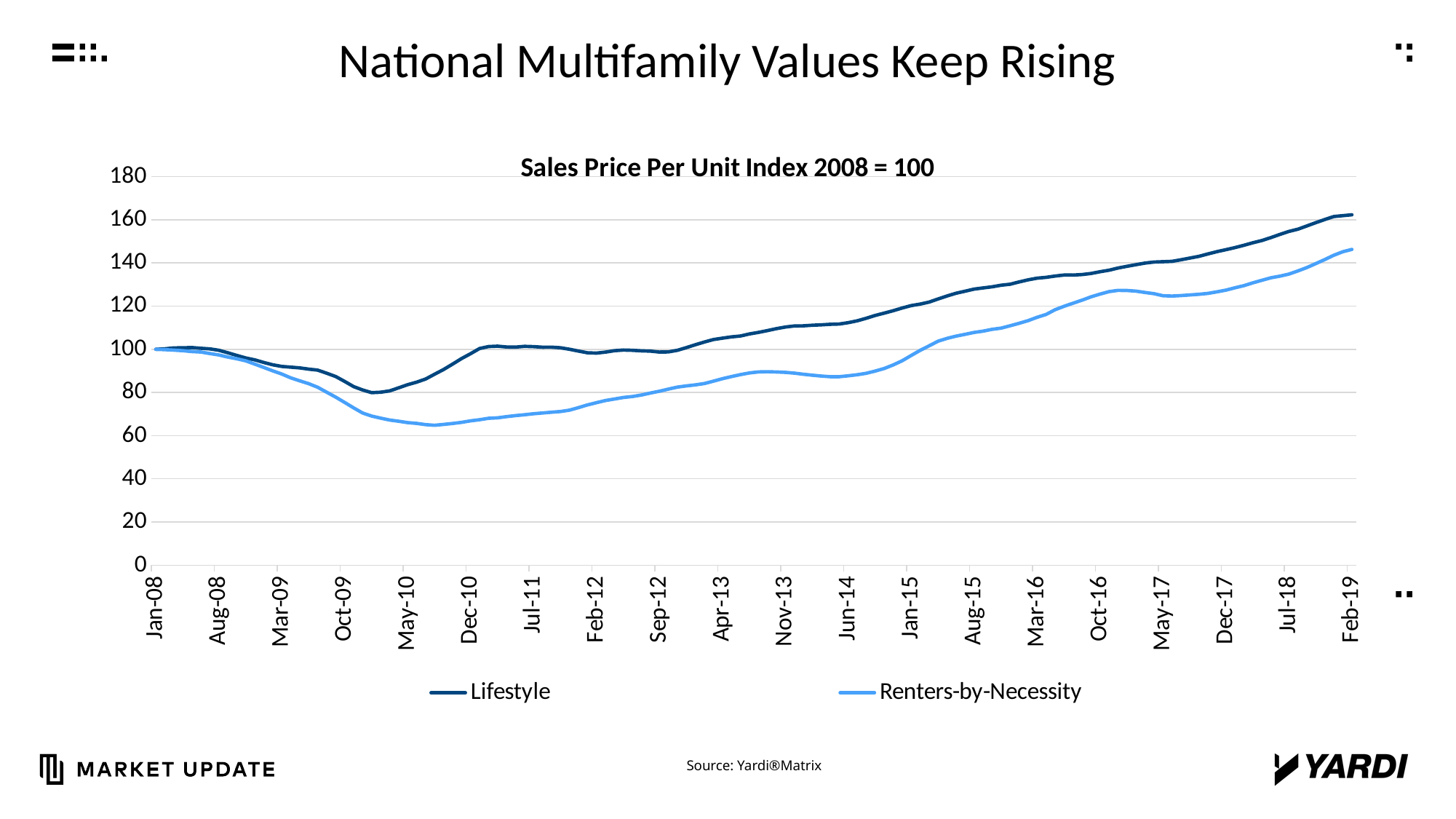
Is the value of the Lifestyle series at Feb-19 greater or less than 140? greater Does the Renters-by-Necessity series rise or fall between Jun-14 and Oct-16? rise What is the value of the Lifestyle series at Jan-08? 100 What is the chart's title? Sales Price Per Unit Index 2008 = 100 How many series does the legend list? 2 At Feb-19, which series has the higher value, Lifestyle or Renters-by-Necessity? Lifestyle Is the value of the Renters-by-Necessity series at May-10 greater or less than 80? less Which two series are shown in the legend? Lifestyle and Renters-by-Necessity Which series falls to the lower minimum value over the period shown? Renters-by-Necessity What kind of chart is shown on the slide? line chart Does the Lifestyle series rise or fall between Jan-08 and May-10? fall Is the value of the Renters-by-Necessity series at Feb-19 greater or less than 120? greater